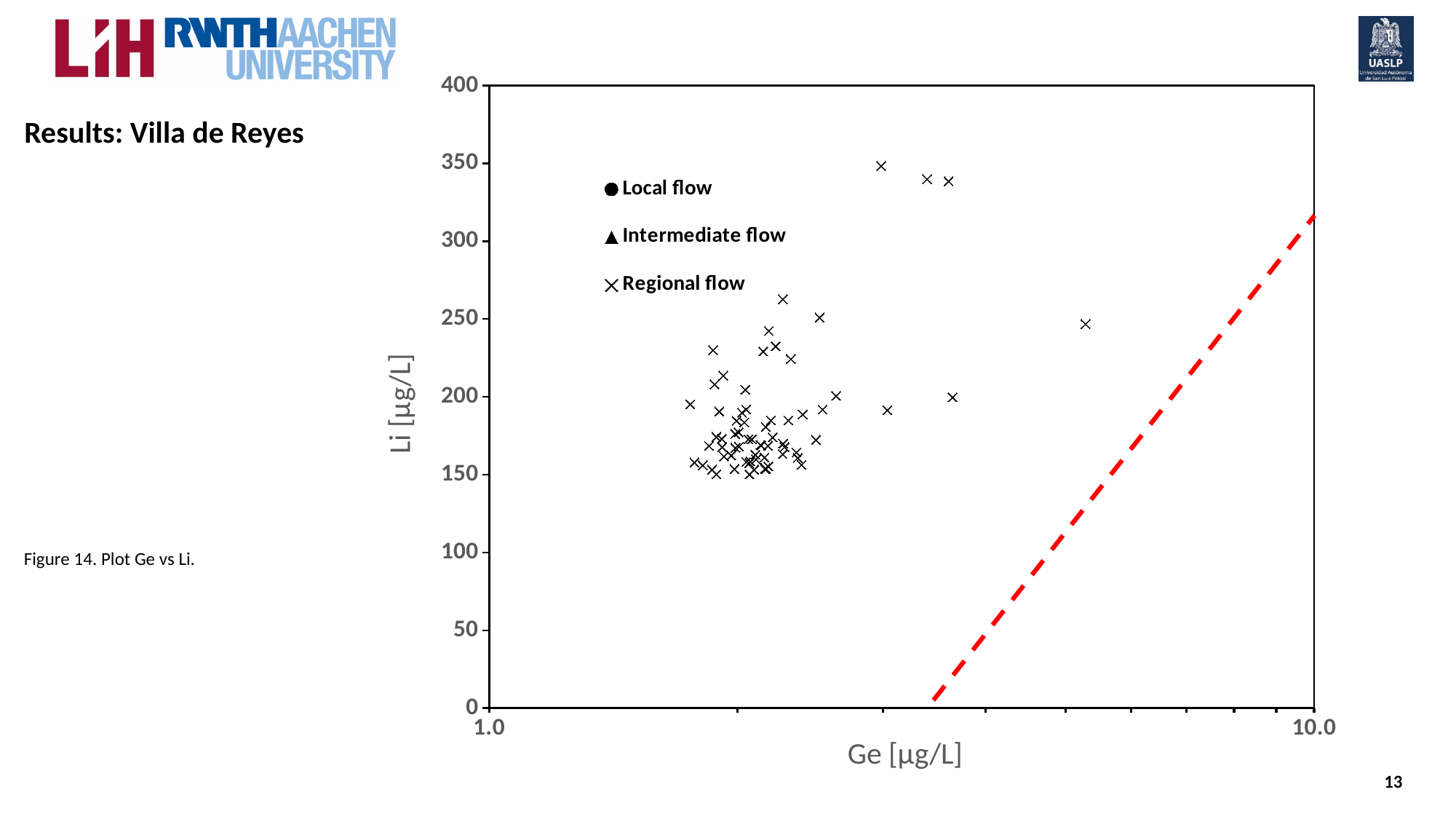
Is the highest Li value plotted greater or less than 300? greater Which series is represented by the x markers in the legend? Regional flow Is the Li value of the point with the largest Ge value (near Ge = 5) greater or less than 200? greater What is the label of the y axis? Li [µg/L] Is the lowest Li value plotted greater or less than 100? greater What kind of chart is shown on the slide? scatter plot How many series does the legend list? 3